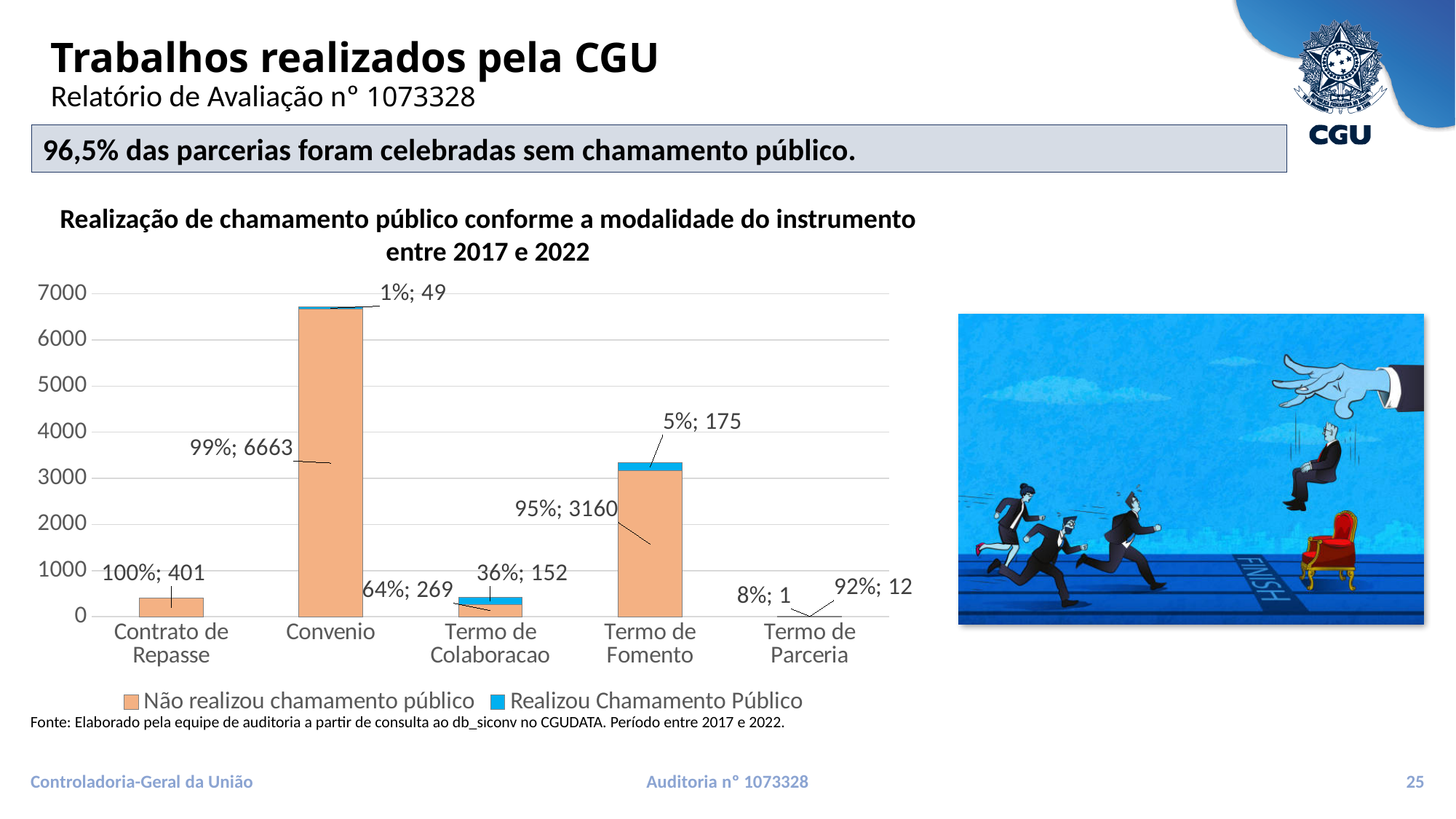
Which category has the shortest stacked bar? Termo de Parceria What is the total of the stacked bar for Termo de Fomento (3160 + 175)? 3335 What data label is shown for 'Realizou Chamamento Público' in the Termo de Fomento category? 5%; 175 What data label is shown for 'Realizou Chamamento Público' in the Termo de Parceria category? 8%; 1 What is the difference between the 'Não realizou chamamento público' counts for Convenio (6663) and Termo de Fomento (3160)? 3503 How many categories are shown on the x axis of the chart? 5 What data label is shown for 'Não realizou chamamento público' in the Convenio category? 99%; 6663 How many series does the chart legend list? 2 Which category has the tallest stacked bar? Convenio What kind of chart is shown on the slide? stacked bar chart What data label is shown for 'Não realizou chamamento público' in the Contrato de Repasse category? 100%; 401 Is the total stacked bar for Convenio greater or less than 6000? greater